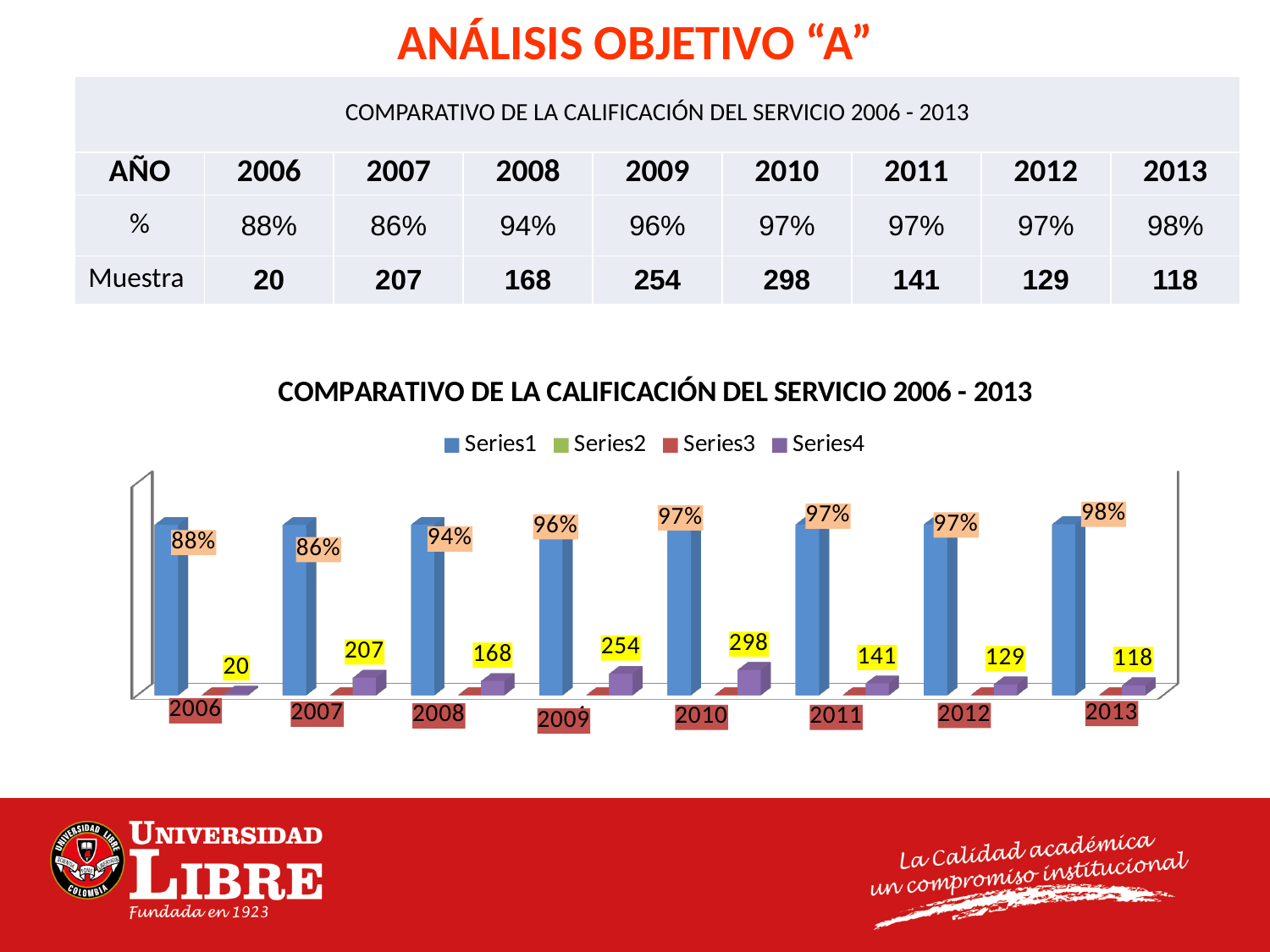
What percentage is labelled on the blue bar for 2013? 98% Which year has the highest value labelled on its purple bar? 2010 Is the purple bar value for 2007 larger or smaller than the purple bar value for 2012? larger How many series does the chart legend list? 4 What value is labelled on the purple bar for 2010? 298 What type of chart is shown on the slide? bar chart How many years (categories) are shown along the x axis of the chart? 8 Which year has the lowest percentage label on its blue bar? 2007 What is the title of the chart? COMPARATIVO DE LA CALIFICACIÓN DEL SERVICIO 2006 - 2013 Which year has the lowest value labelled on its purple bar? 2006 What is the difference between the purple bar values for 2009 and 2008? 86 What percentage is labelled on the blue bar for 2006? 88%